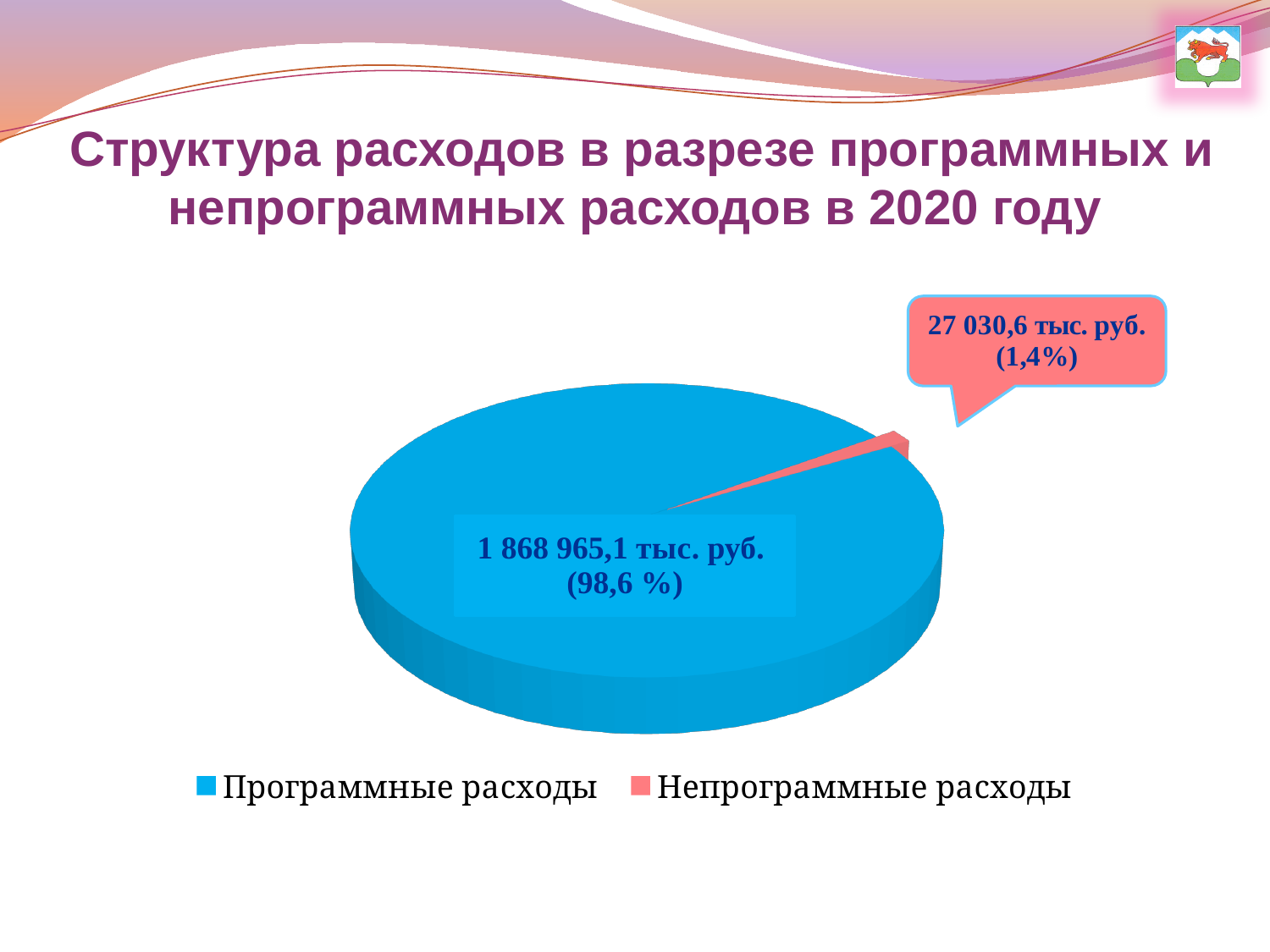
What is the difference between Программные расходы and Непрограммные расходы in тыс. руб.? 1 841 934,5 тыс. руб. What type of chart is shown on the slide? Pie chart Which category has the largest slice of the pie? Программные расходы How many categories does the pie chart have? 2 What is the value for Программные расходы? 1 868 965,1 тыс. руб. What share of the pie does Непрограммные расходы take? 1,4% Which is larger, Программные расходы or Непрограммные расходы? Программные расходы Which category has the smallest slice of the pie? Непрограммные расходы What is the total of the two slices in тыс. руб.? 1 895 995,7 тыс. руб. What share of the pie does Программные расходы take? 98,6 % What colour is the slice for Непрограммные расходы? Pink (red) What is the value for Непрограммные расходы? 27 030,6 тыс. руб.